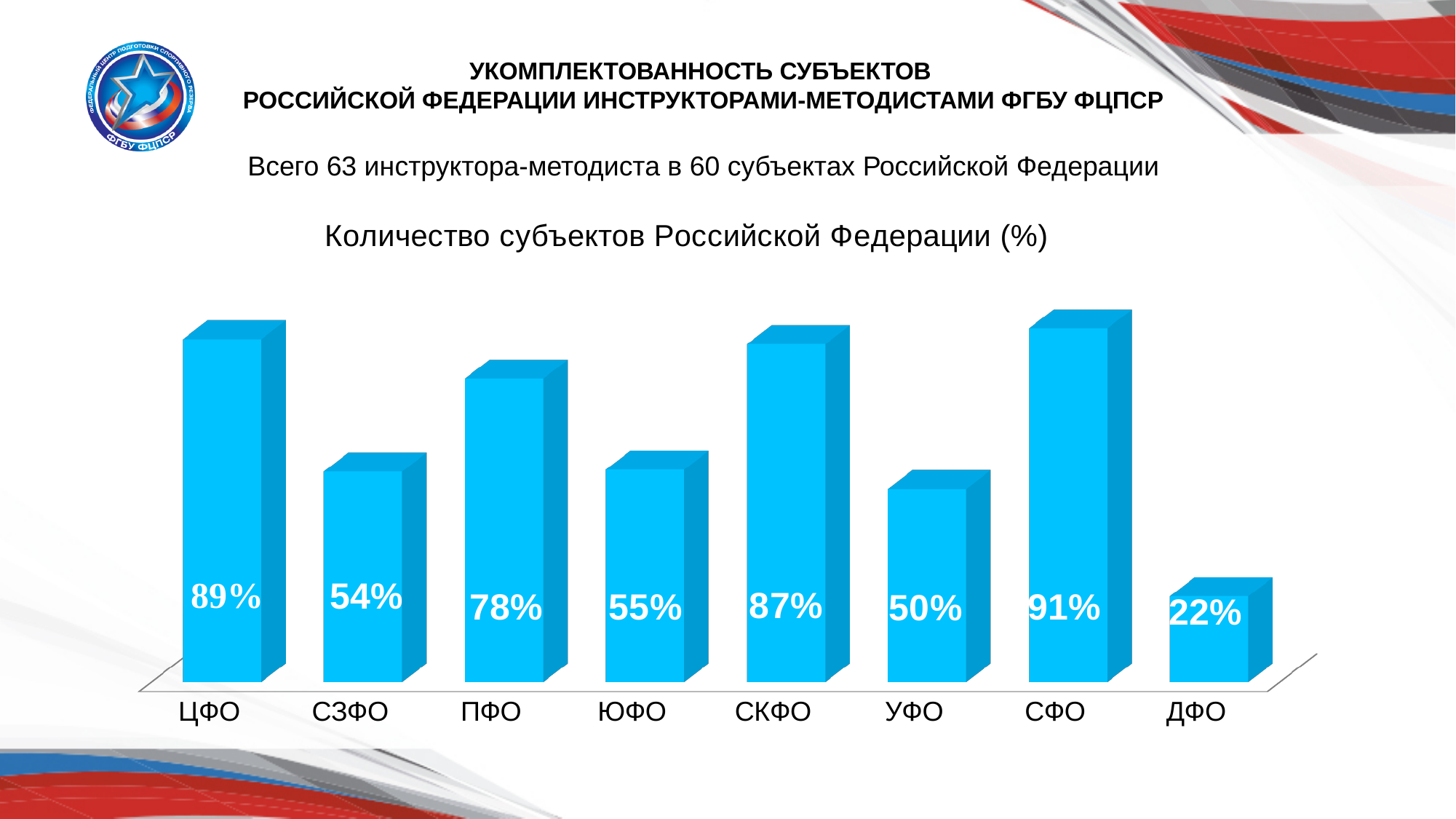
How many categories are shown on the x axis? 8 What is the difference between the values for СФО and ДФО? 69% What is the title of the chart? Количество субъектов Российской Федерации (%) What is the value for ЦФО? 89% Which is larger, the value for ЮФО or the value for УФО? ЮФО What is the value for ДФО? 22% What is the difference between the values for ПФО and СЗФО? 24% What colour are the bars in the chart? blue What is the value for СКФО? 87% Which category has the lowest value? ДФО Which category has the highest value? СФО What kind of chart is shown on the slide? bar chart